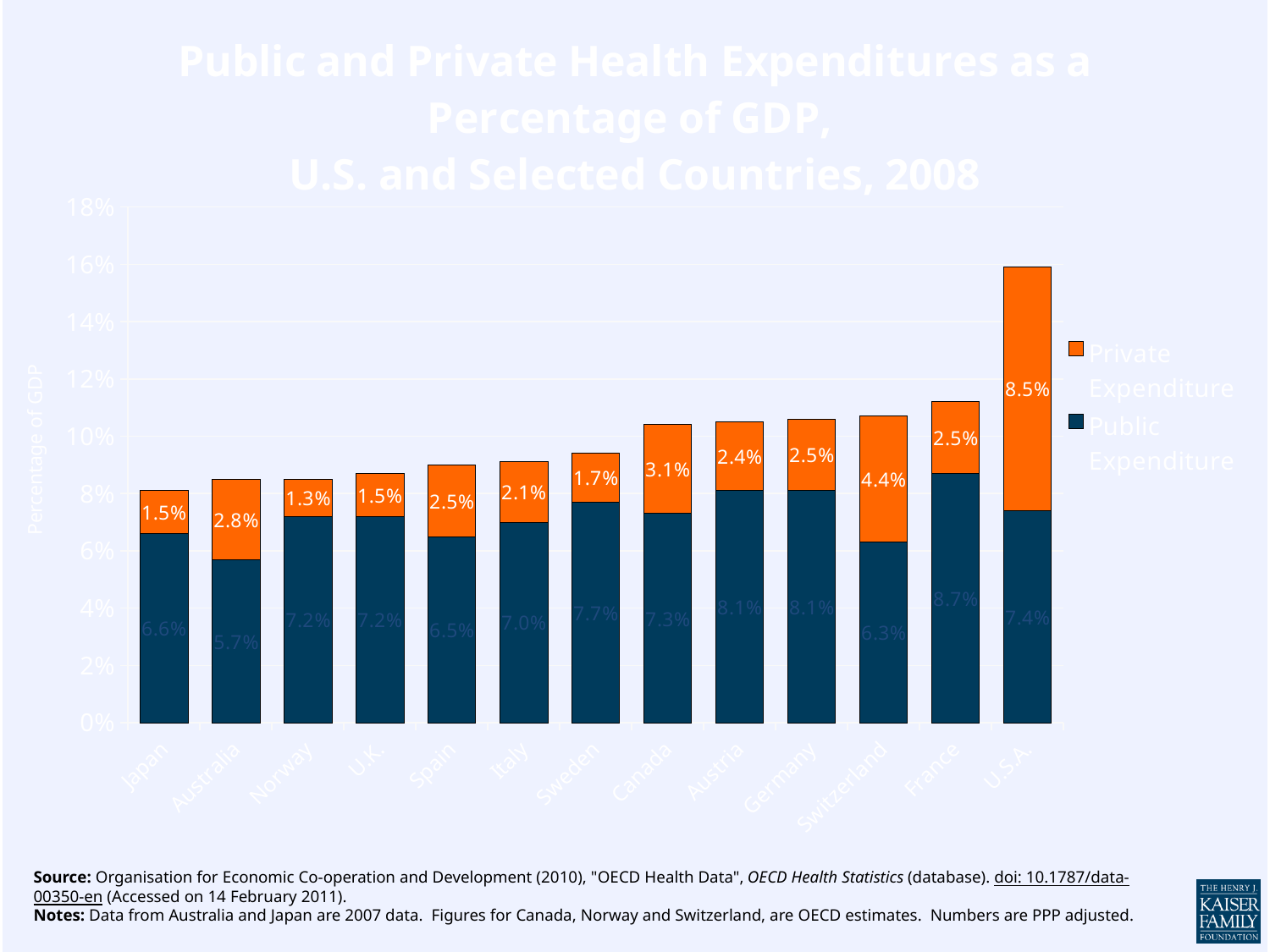
What is the private expenditure value shown for the U.S.A.? 8.5% What is the private expenditure value shown for Switzerland? 4.4% What kind of chart is shown on the slide? Stacked bar chart Which has the larger private expenditure, Canada or Austria? Canada Is the total health expenditure bar for Japan greater or less than 10%? less Which country has the highest private expenditure as a percentage of GDP? U.S.A. How many countries are shown on the chart? 13 What is the private expenditure value shown for Canada? 3.1% How many series does the legend list? 2 How much larger is the private expenditure for the U.S.A. than for Switzerland? 4.1 percentage points Is the total health expenditure bar for the U.S.A. greater or less than 14%? greater Which country has the lowest private expenditure as a percentage of GDP? Norway